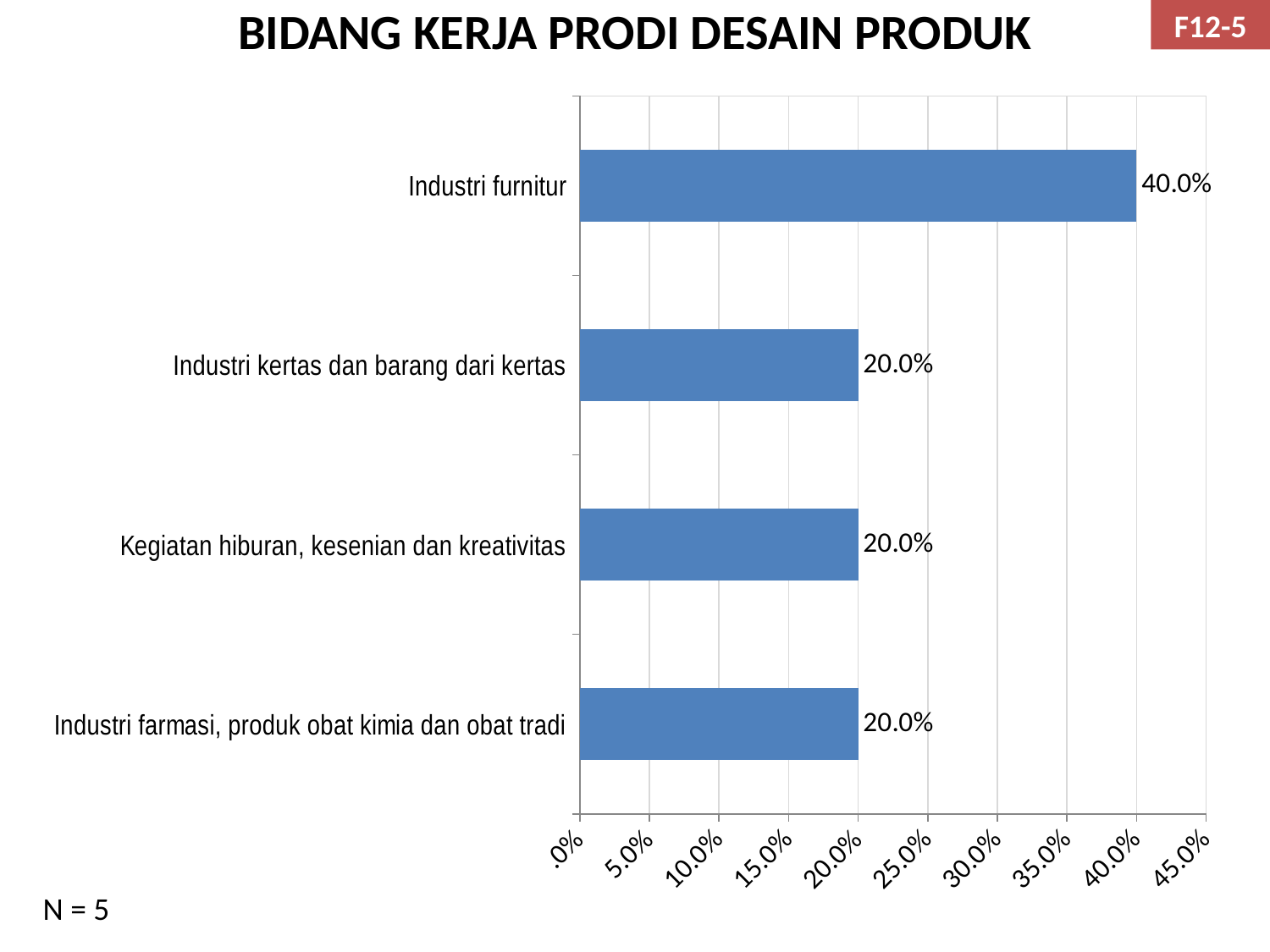
What is the difference between the values for Industri furnitur and Industri kertas dan barang dari kertas? 20.0% What is the title of the chart? BIDANG KERJA PRODI DESAIN PRODUK What is the value for Industri furnitur? 40.0% What is the value for Kegiatan hiburan, kesenian dan kreativitas? 20.0% What is the value for Industri farmasi, produk obat kimia dan obat tradi? 20.0% Is the value for Industri furnitur greater or less than 35.0%? greater What is the sample size (N) shown on the slide? 5 Which category has the highest value? Industri furnitur What kind of chart is shown on the slide? bar chart How many categories are shown in the chart? 4 What is the value for Industri kertas dan barang dari kertas? 20.0% Which is larger, the value for Industri furnitur or the value for Kegiatan hiburan, kesenian dan kreativitas? Industri furnitur